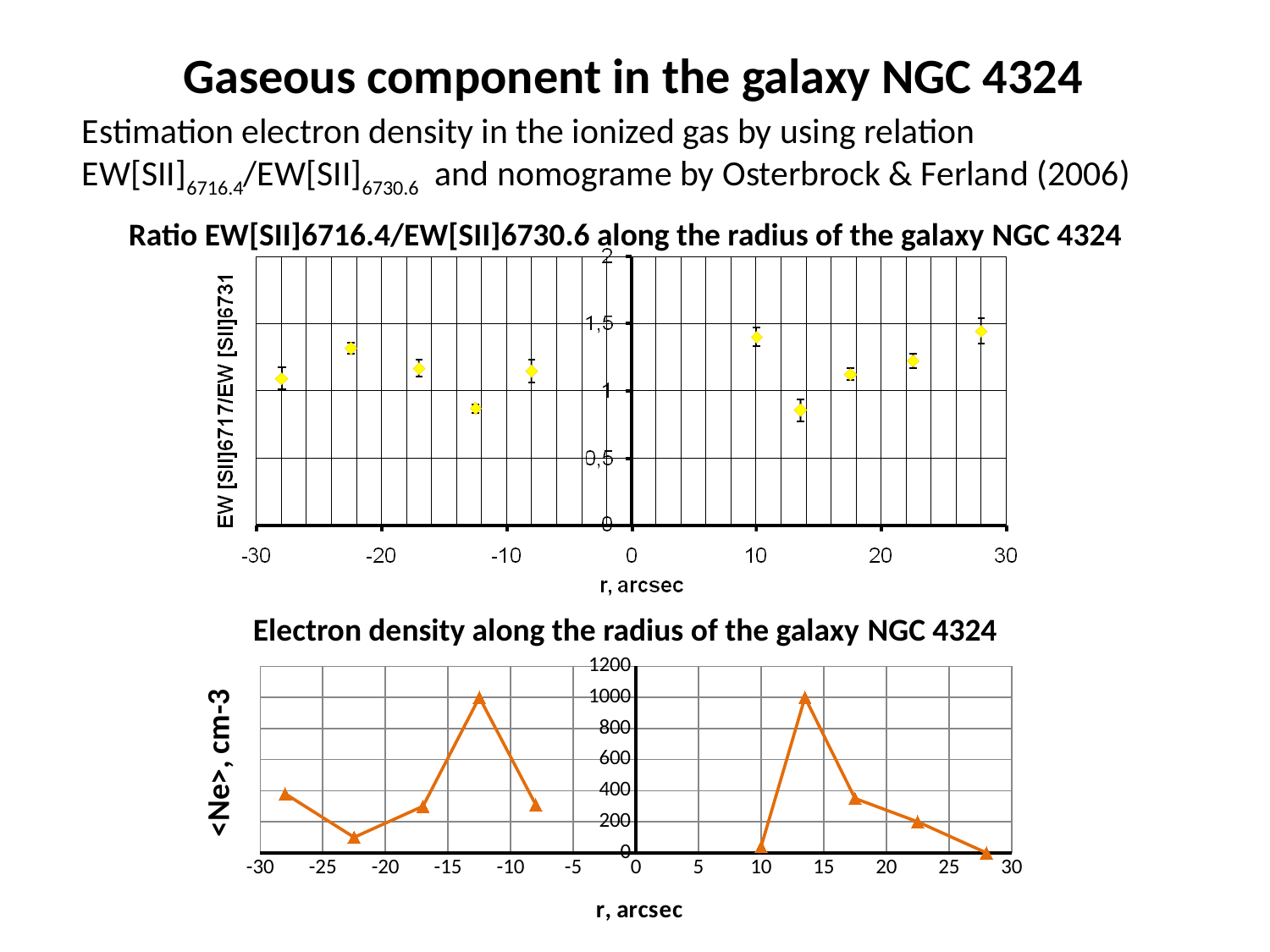
In the bottom chart (Electron density), is the electron density at r ≈ -12.5 arcsec greater or less than 800? greater What kind of chart is the bottom chart titled 'Electron density along the radius of the galaxy NGC 4324'? Line chart In the top chart (Ratio EW[SII]), is the ratio at r = -22 arcsec greater or less than 1? greater In the bottom chart (Electron density), which has the higher electron density: the point at r ≈ -28 arcsec or the point at r ≈ -22.5 arcsec? r ≈ -28 arcsec In the bottom chart (Electron density), does the electron density rise or fall as r increases from about 13.5 to 28 arcsec? fall In the top chart (Ratio EW[SII]), is the ratio at r ≈ 13.5 arcsec greater or less than 1? less In the top chart (Ratio EW[SII]), which has the higher ratio: the point at r = 10 arcsec or the point at r ≈ 13.5 arcsec? r = 10 arcsec In the top chart (Ratio EW[SII]), how many data points are plotted? 10 What kind of chart is the top chart titled 'Ratio EW[SII]6716.4/EW[SII]6730.6 along the radius of the galaxy NGC 4324'? Scatter chart with error bars In the bottom chart (Electron density), how many data points are plotted? 10 What is the y-axis label of the bottom chart (Electron density)? <Ne>, cm-3